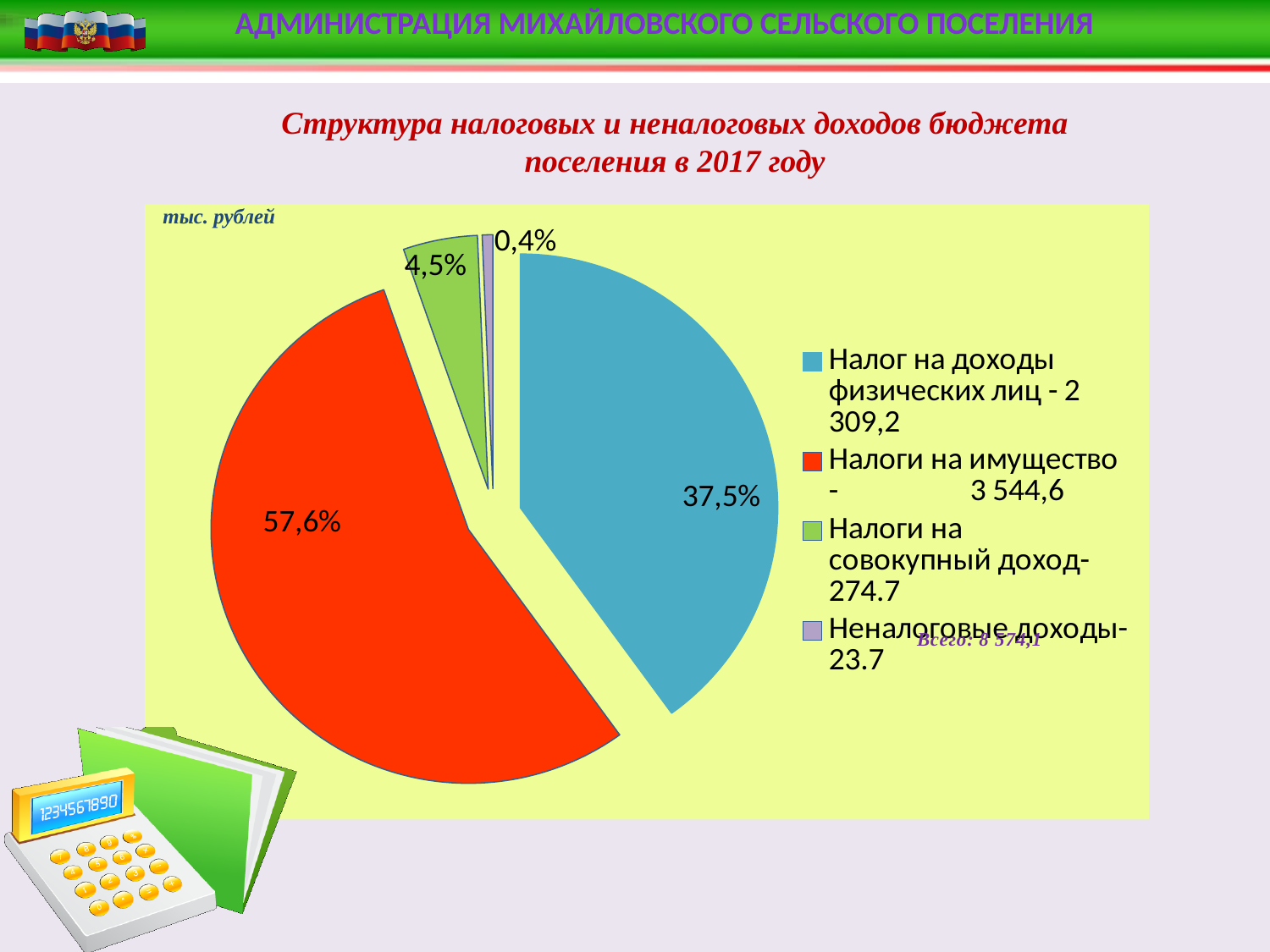
Which category has the largest slice of the pie? Налоги на имущество What value is given in the legend for Налог на доходы физических лиц? 2 309,2 What share of the pie is labelled for Налог на доходы физических лиц? 37,5% What unit is indicated in the top-left corner of the chart area? тыс. рублей Which category has the smallest slice of the pie? Неналоговые доходы How many entries does the legend list? 4 What value is given in the legend for Налоги на имущество? 3 544,6 What share of the pie is labelled for Неналоговые доходы? 0,4% What share of the pie is labelled for Налоги на совокупный доход? 4,5% What kind of chart is shown on the slide? pie chart How many slices does the pie chart have? 4